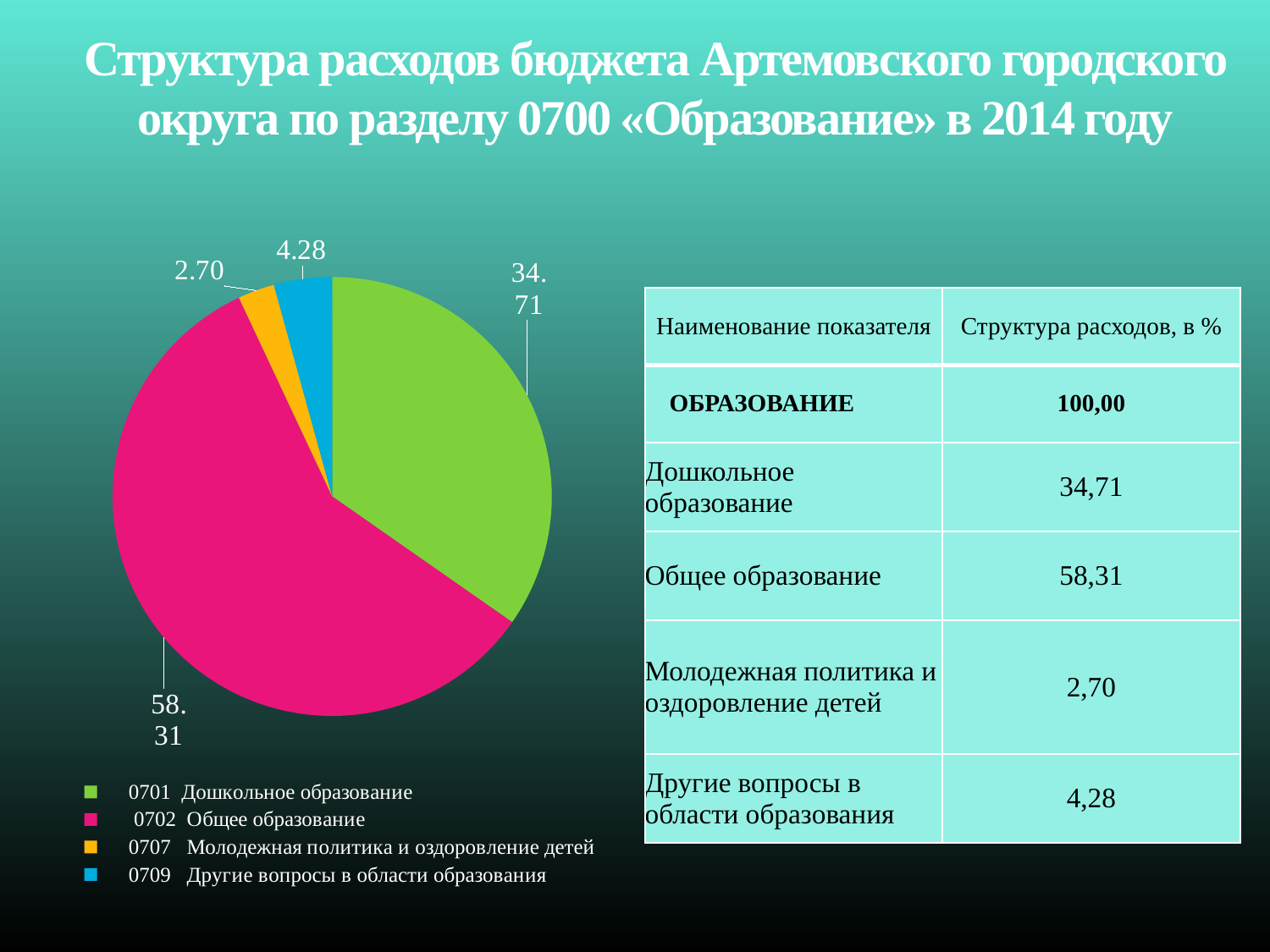
Which category has the smallest slice in the pie chart? 0707 Молодежная политика и оздоровление детей Which is larger in the pie chart: the value for 0709 Другие вопросы в области образования or for 0707 Молодежная политика и оздоровление детей? 0709 Другие вопросы в области образования How many entries does the legend of the pie chart list? 4 What is the value shown for 0707 Молодежная политика и оздоровление детей in the pie chart? 2.70 What is the value shown for 0709 Другие вопросы в области образования in the pie chart? 4.28 Which category has the largest slice in the pie chart? 0702 Общее образование What is the value shown for 0701 Дошкольное образование in the pie chart? 34.71 What kind of chart is shown on the slide? pie chart How many slices does the pie chart have? 4 What colour is the slice for 0701 Дошкольное образование in the pie chart? green What is the difference between the values for 0702 Общее образование and 0701 Дошкольное образование in the pie chart? 23.60 What is the value shown for 0702 Общее образование in the pie chart? 58.31